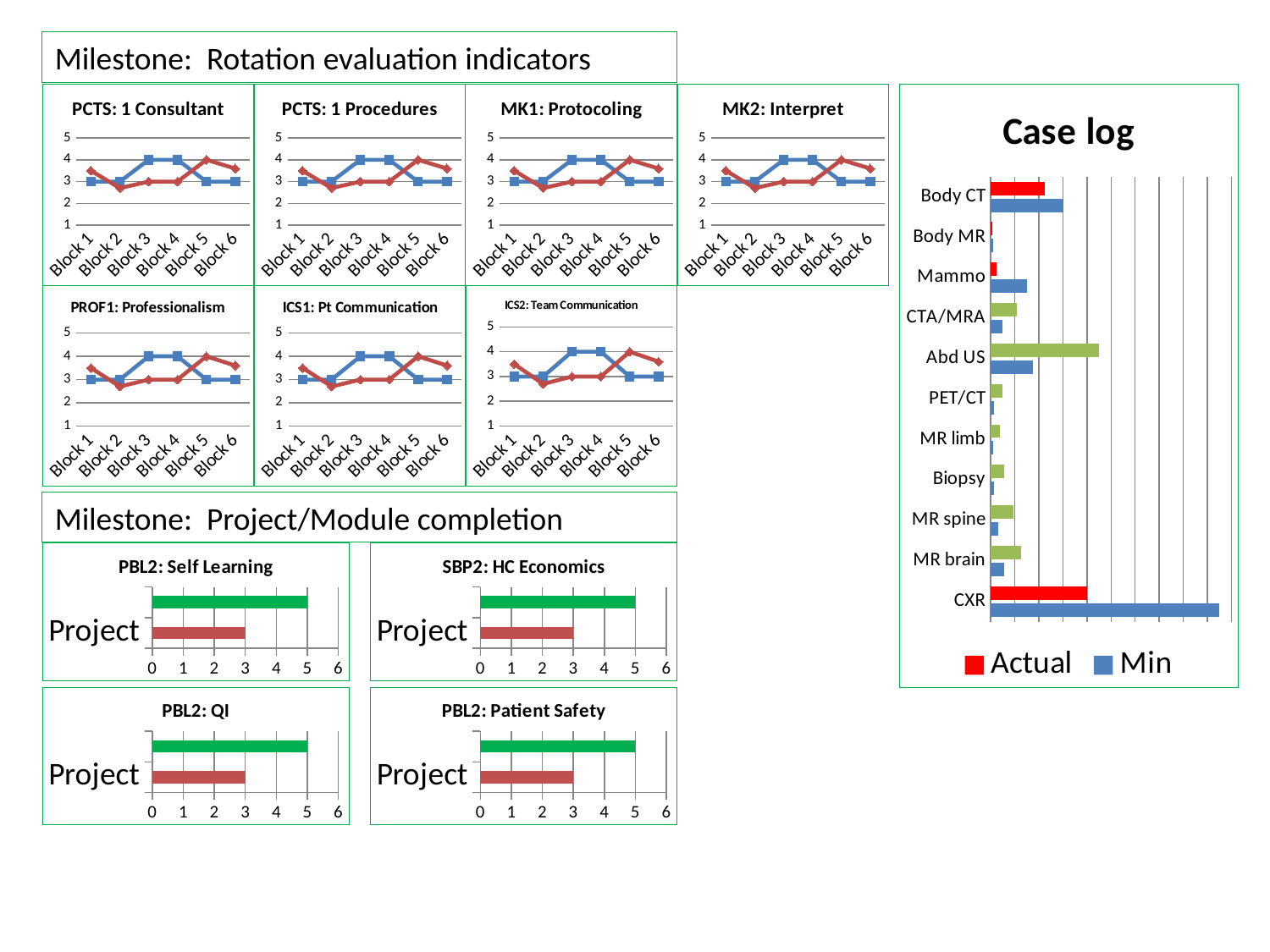
How many blocks are plotted on the x axis of the PCTS: 1 Consultant chart? 6 In the PBL2: Self Learning chart, what is the value of the green bar for Project? 5 In the Case log chart, which category has the highest Actual value? Abd US What are the legend entries of the Case log chart? Actual, Min What kind of chart is the Case log chart? bar chart How many series does the legend of the Case log chart list? 2 In the PBL2: QI chart, what is the value of the red bar for Project? 3 In the MK2: Interpret chart, is the value of the blue line at Block 2 greater or less than 4? less In the Case log chart, which category has the highest Min value? CXR In the Case log chart, is the Actual or the Min value larger for Body CT? Min How many categories are shown in the Case log chart? 11 In the SBP2: HC Economics chart, what is the difference between the green bar and the red bar for Project? 2